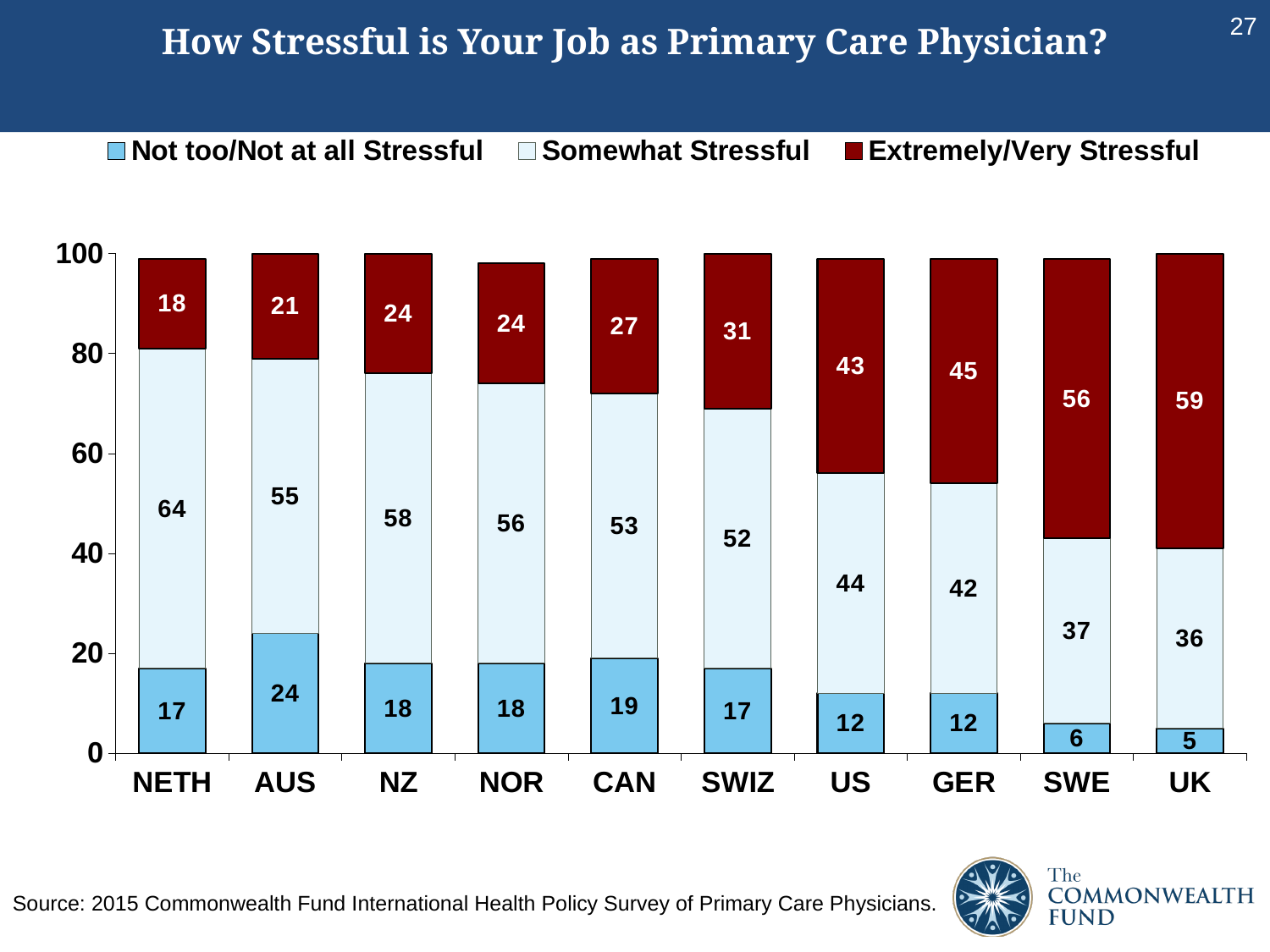
Which series is shown in dark red in the legend? Extremely/Very Stressful How many countries are shown on the x axis? 10 Which country has the highest value for "Extremely/Very Stressful"? UK What is the difference between the "Extremely/Very Stressful" values for SWE and NETH? 38 How many series does the legend list? 3 What is the value for "Somewhat Stressful" for NETH? 64 What is the value for "Not too/Not at all Stressful" for AUS? 24 What is the total of the stacked bar for SWIZ? 100 Which country has the lowest value for "Not too/Not at all Stressful"? UK Which is larger: the "Somewhat Stressful" value for US or for GER? US What kind of chart is shown on the slide? Stacked bar chart What is the value for "Extremely/Very Stressful" for the UK? 59